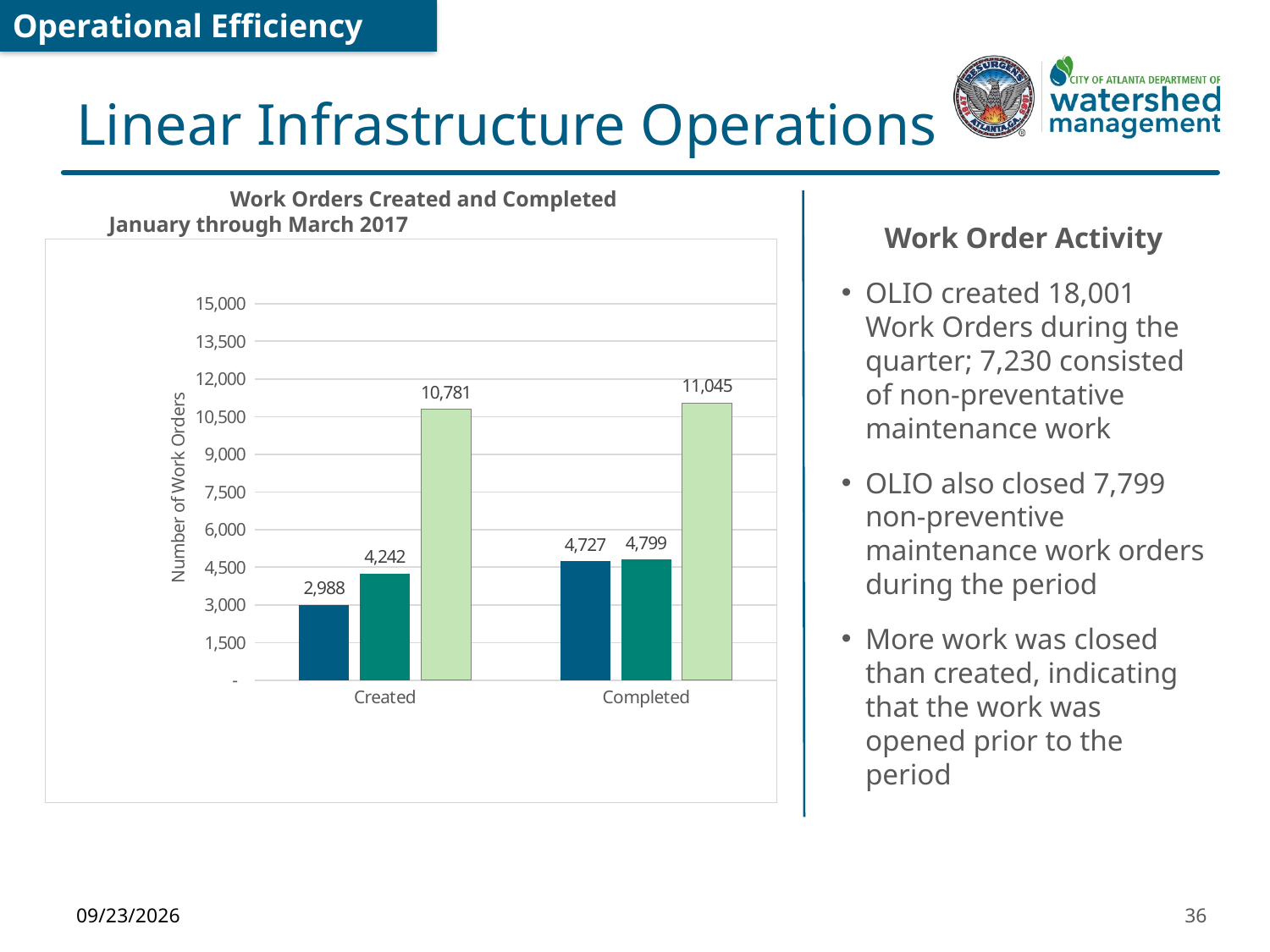
Is the value of the light green bar for Created greater or less than 12,000? less How many bars are plotted for each category in the chart? 3 What is the value of the light green bar for Created? 10,781 What is the difference between the light green bar for Completed and the light green bar for Created? 264 What is the value of the teal bar for Created? 4,242 Which bar has the highest value in the chart? the light green bar for Completed (11,045) What is the value of the dark blue bar for Completed? 4,727 Which bar has the lowest value in the chart? the dark blue bar for Created (2,988) Is the teal bar larger for Created or for Completed? Completed What kind of chart is shown on the slide? bar chart How many categories are shown on the x axis of the chart? 2 What is the title of the chart's vertical axis? Number of Work Orders